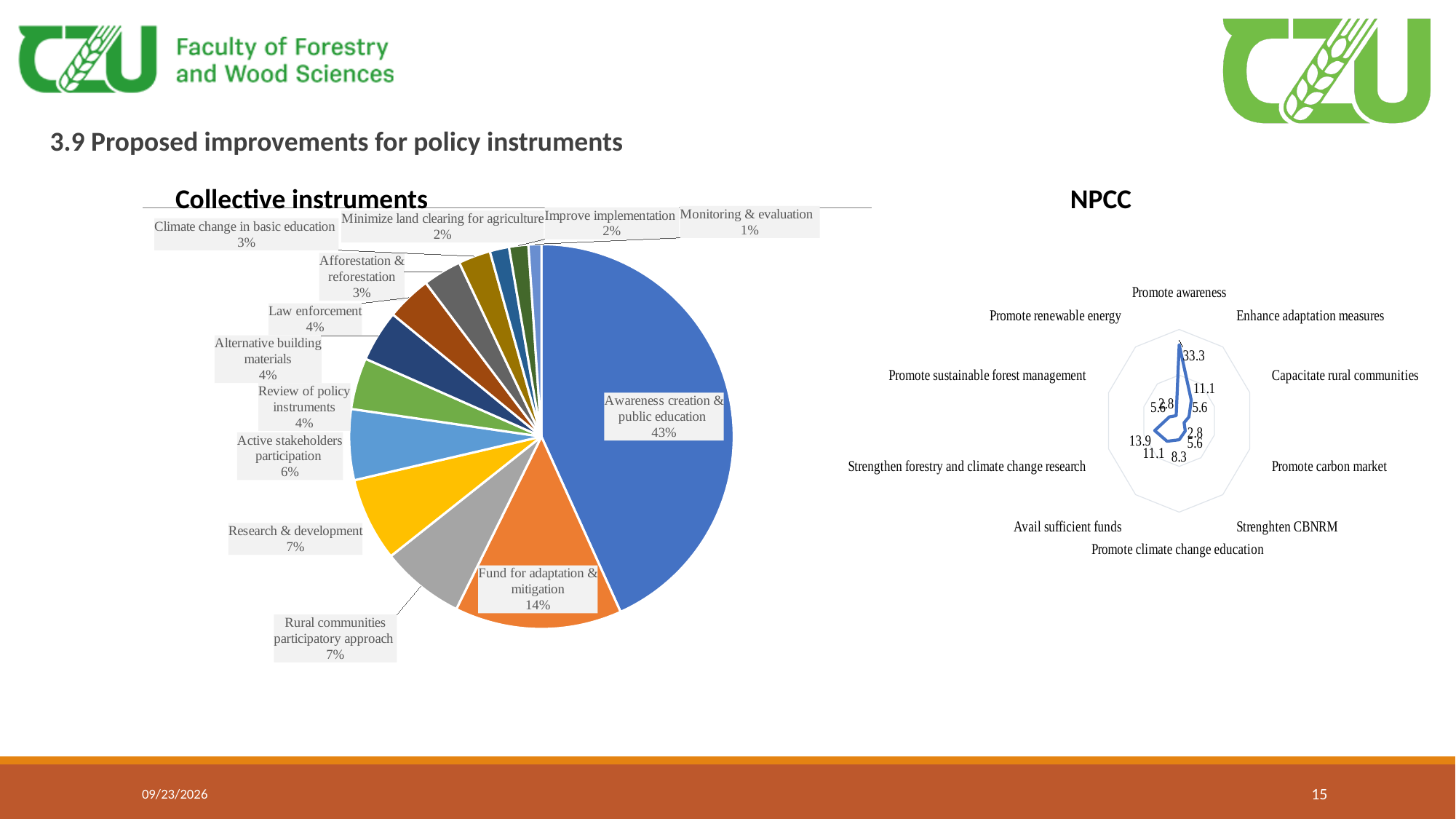
In the 'Collective instruments' pie chart, what share is 'Fund for adaptation & mitigation'? 14% In the 'Collective instruments' pie chart, what is the difference between the shares of 'Awareness creation & public education' and 'Fund for adaptation & mitigation'? 29% In the 'Collective instruments' pie chart, which category has the largest share? Awareness creation & public education In the 'NPCC' chart, which category has the highest value? Promote awareness In the 'NPCC' chart, what is the value for 'Promote awareness'? 33.3 How many categories are shown in the 'NPCC' radar chart? 10 In the 'Collective instruments' pie chart, which category has the smallest share? Monitoring & evaluation How many categories are shown in the 'Collective instruments' pie chart? 13 In the 'Collective instruments' pie chart, what share is 'Active stakeholders participation'? 6% What type of chart is the 'Collective instruments' chart? pie chart In the 'Collective instruments' pie chart, what share is 'Awareness creation & public education'? 43% In the 'Collective instruments' pie chart, which is larger: 'Research & development' or 'Law enforcement'? Research & development